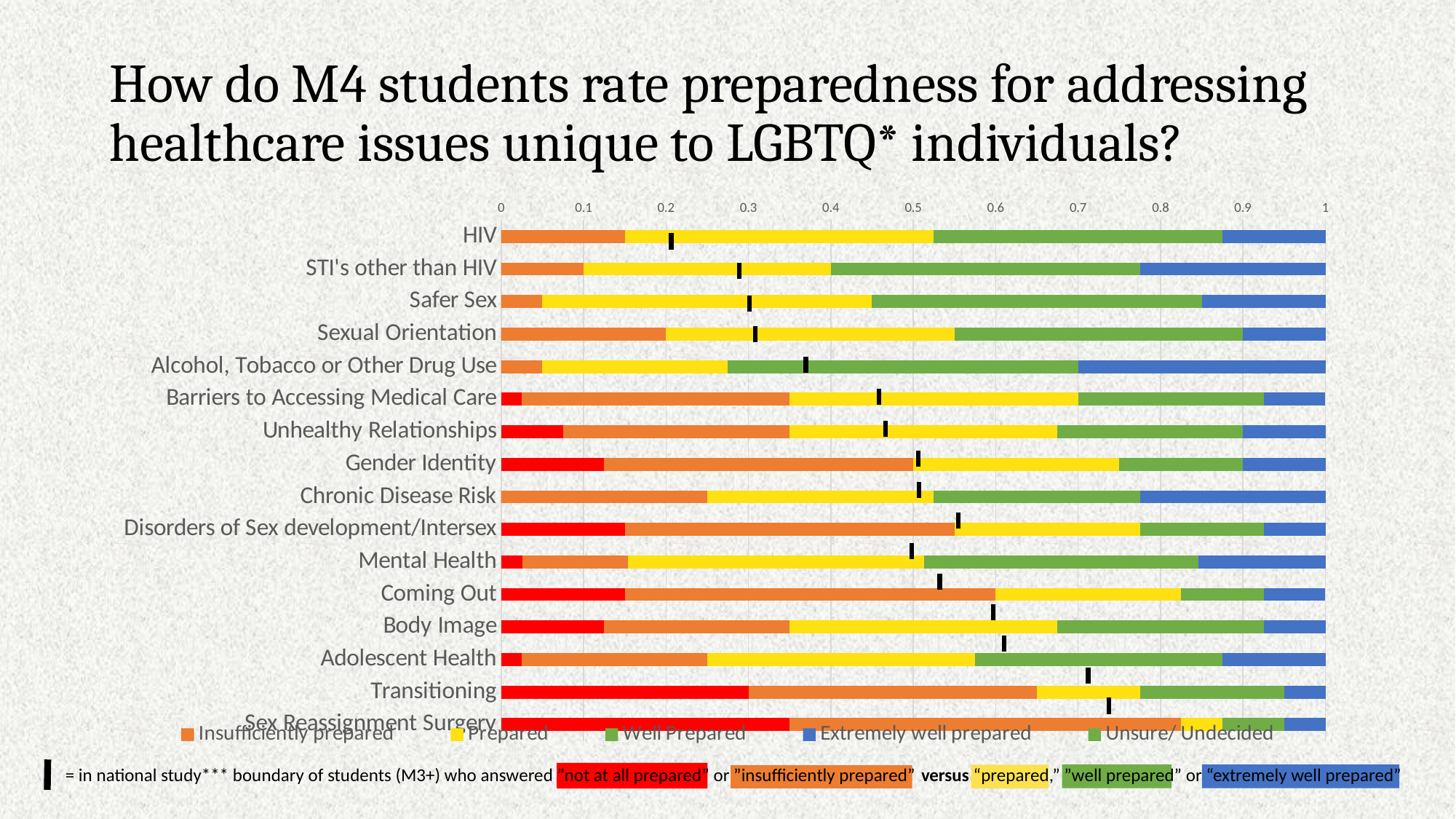
Which has a larger red (not at all prepared) segment: Transitioning or Gender Identity? Transitioning What is the title of the slide containing the chart? How do M4 students rate preparedness for addressing healthcare issues unique to LGBTQ* individuals? Is the 'Insufficiently prepared' value for Safer Sex greater or less than 0.1? less What colour represents the 'Prepared' series in the legend? Yellow What kind of chart is shown on the slide? Stacked bar chart Which category has the largest red (not at all prepared) segment? Sex Reassignment Surgery How many categories (topics) are listed on the chart's vertical axis? 16 How many series does the chart legend list? 5 Which category has the largest 'Extremely well prepared' (blue) segment? Alcohol, Tobacco or Other Drug Use Is the 'Insufficiently prepared' value for HIV greater or less than 0.2? less Is the 'Insufficiently prepared' value for Chronic Disease Risk greater or less than 0.2? greater